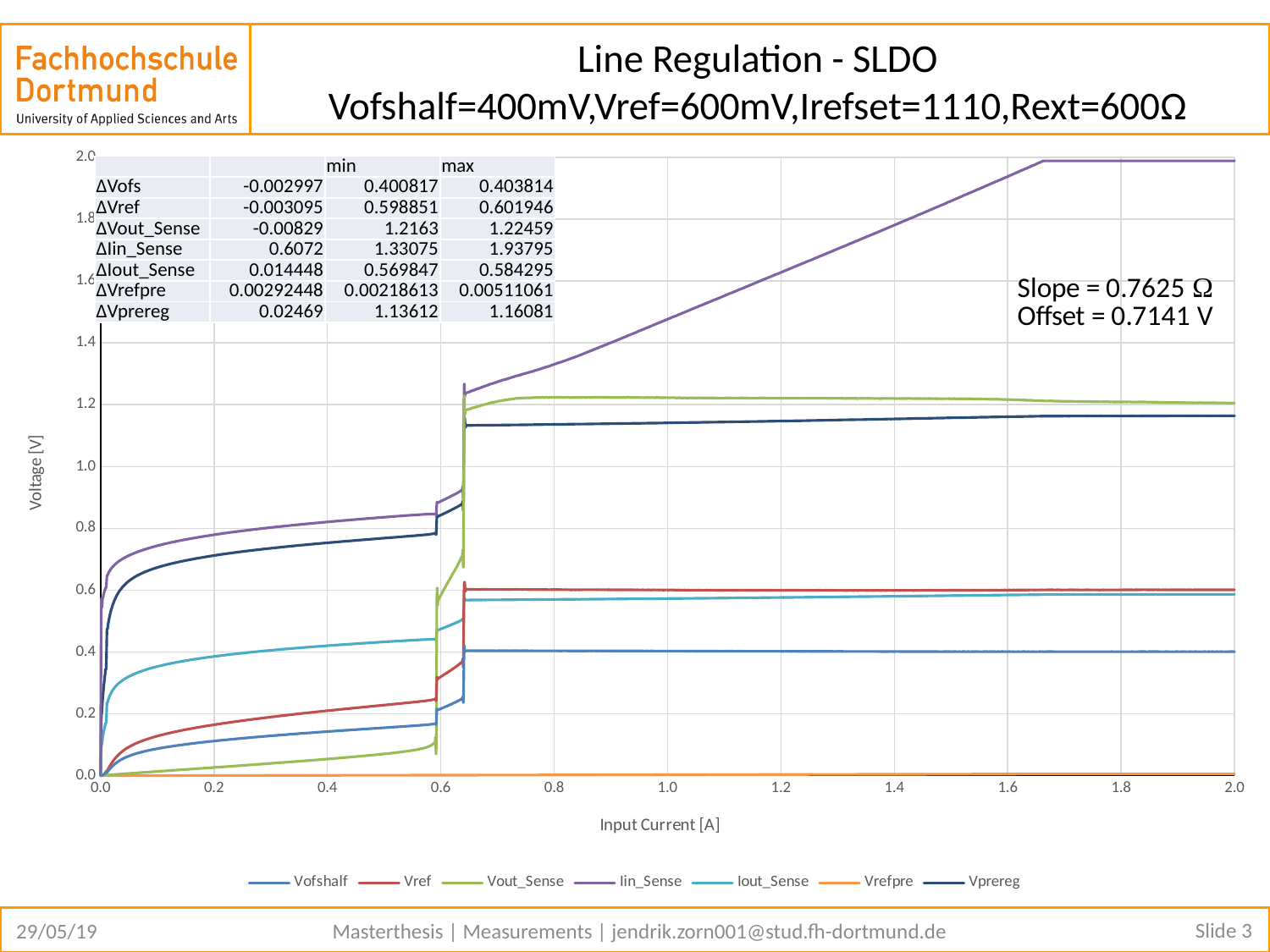
Is the value of Iin_Sense at an input current of 2.0 A greater or less than 1.8? greater According to the table on the chart, what is the max value for ΔVref? 0.601946 Does the Iin_Sense curve rise or fall as input current increases from 0.0 to 1.6 A? rise Which series has the highest voltage at an input current of 2.0 A? Iin_Sense What kind of chart is shown on the slide? line chart Is the value of Vout_Sense at an input current of 1.0 A greater or less than 1.0? greater What is the label of the x axis? Input Current [A] What is the label of the y axis? Voltage [V] How many series does the legend list? 7 Is the value of Vofshalf at an input current of 1.0 A greater or less than 0.6? less Which series has the lowest voltage across the whole input current range? Vrefpre What slope value is annotated on the chart? 0.7625 Ω